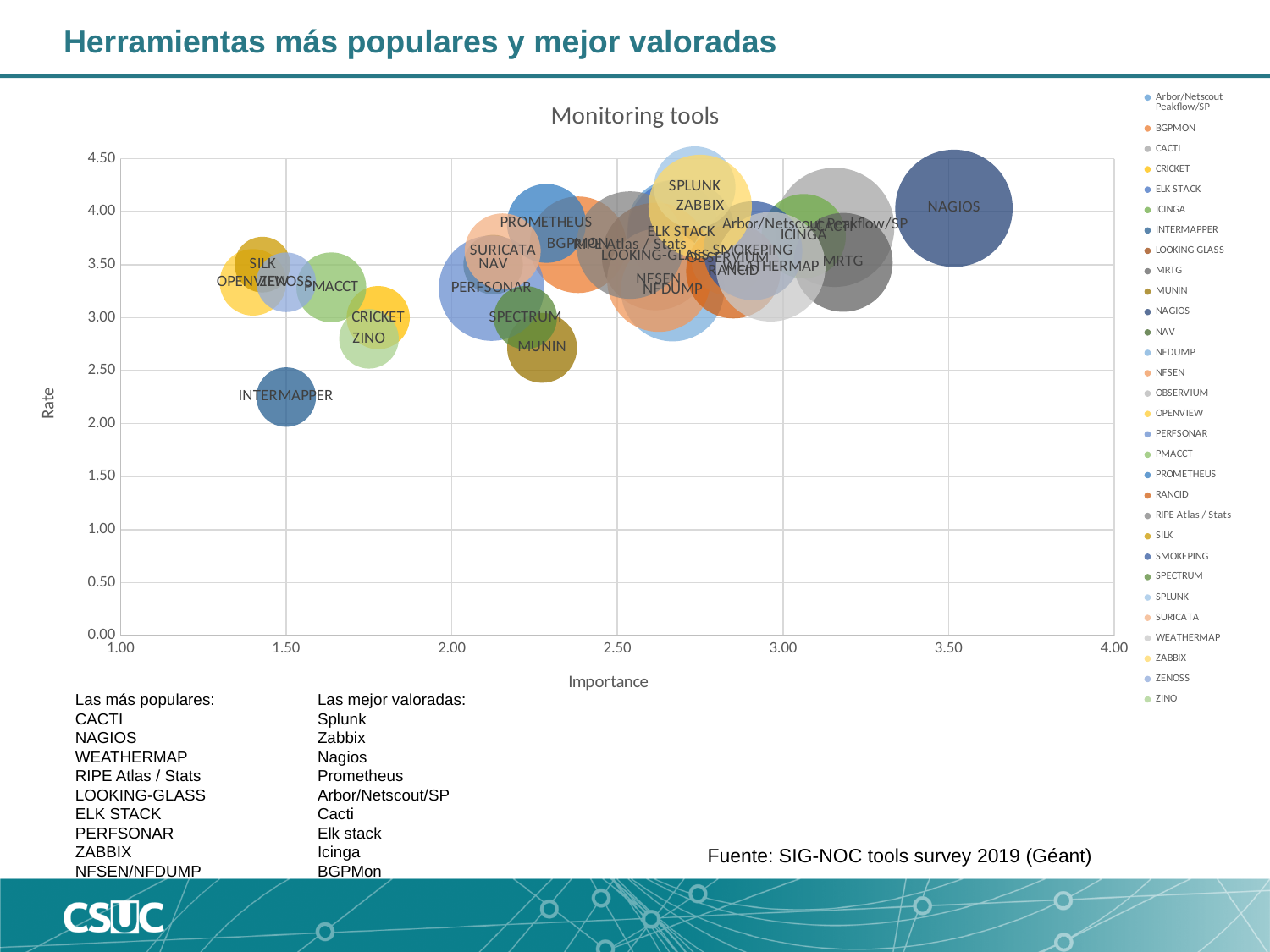
Is the Importance for SILK greater or less than 2.00? less How many tools does the chart legend list? 30 Is the Importance for NAGIOS greater or less than 3.00? greater Which tool has the lowest Rate in the chart? INTERMAPPER Which tool has the highest Importance in the chart? NAGIOS Which has the higher Importance, NAGIOS or INTERMAPPER? NAGIOS What is the title of the chart? Monitoring tools Which has the higher Rate, SPLUNK or MUNIN? SPLUNK What are the labels of the x axis and the y axis of the chart? Importance (x axis) and Rate (y axis) Is the Rate for INTERMAPPER greater or less than 2.50? less What kind of chart is shown on the slide? Bubble chart